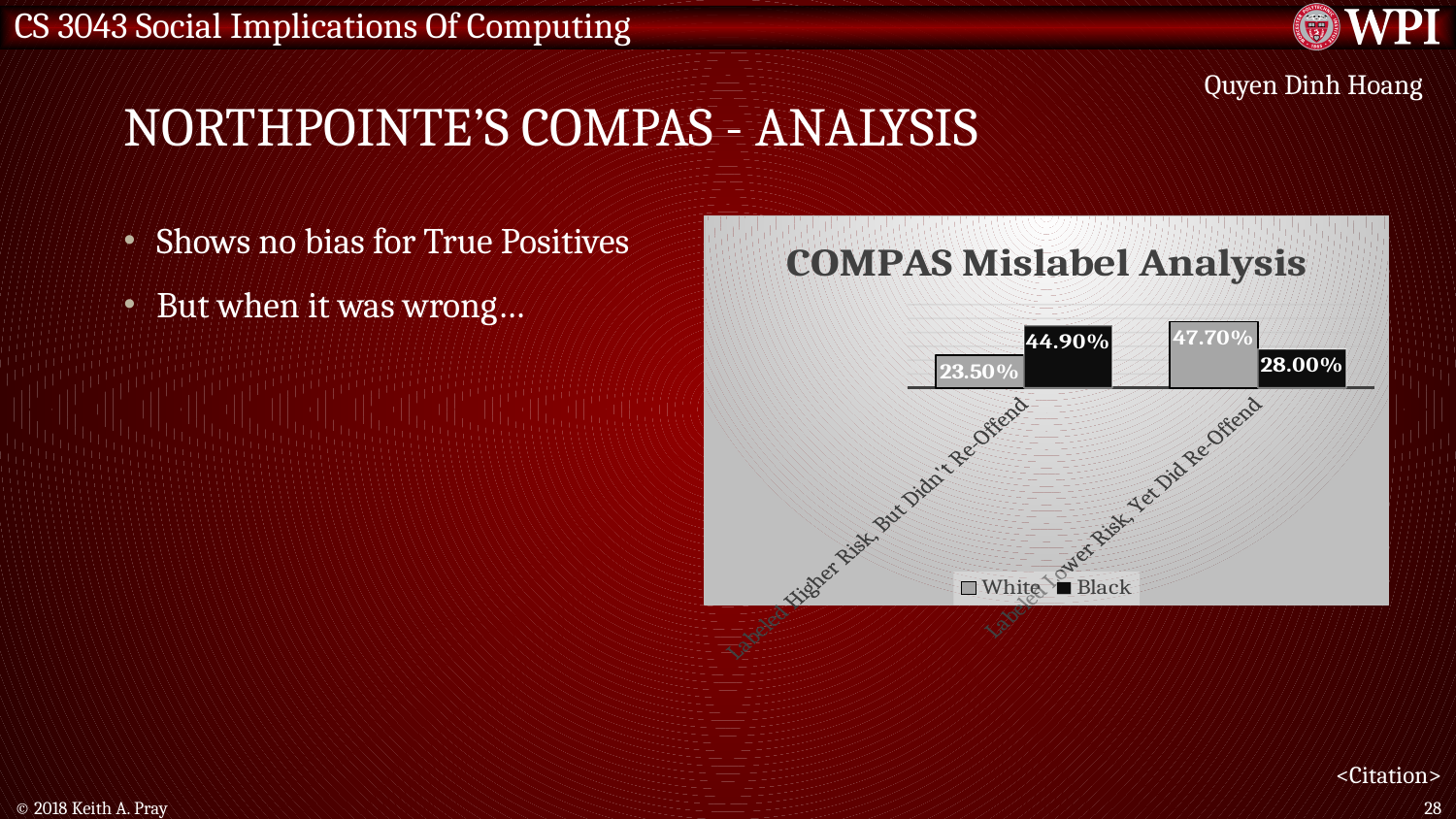
What is the value for White in the category "Labeled Higher Risk, But Didn't Re-Offend"? 23.50% What is the difference between the White and Black values in the category "Labeled Lower Risk, Yet Did Re-Offend"? 19.70% What kind of chart is shown on the slide? Bar chart Which series has the higher value in the category "Labeled Higher Risk, But Didn't Re-Offend"? Black Which series has the higher value in the category "Labeled Lower Risk, Yet Did Re-Offend"? White What is the difference between the Black and White values in the category "Labeled Higher Risk, But Didn't Re-Offend"? 21.40% What is the value for Black in the category "Labeled Higher Risk, But Didn't Re-Offend"? 44.90% What is the title of the chart? COMPAS Mislabel Analysis What is the value for White in the category "Labeled Lower Risk, Yet Did Re-Offend"? 47.70% How many categories are shown on the x axis of the chart? 2 What is the value for Black in the category "Labeled Lower Risk, Yet Did Re-Offend"? 28.00% How many series does the chart's legend list? 2